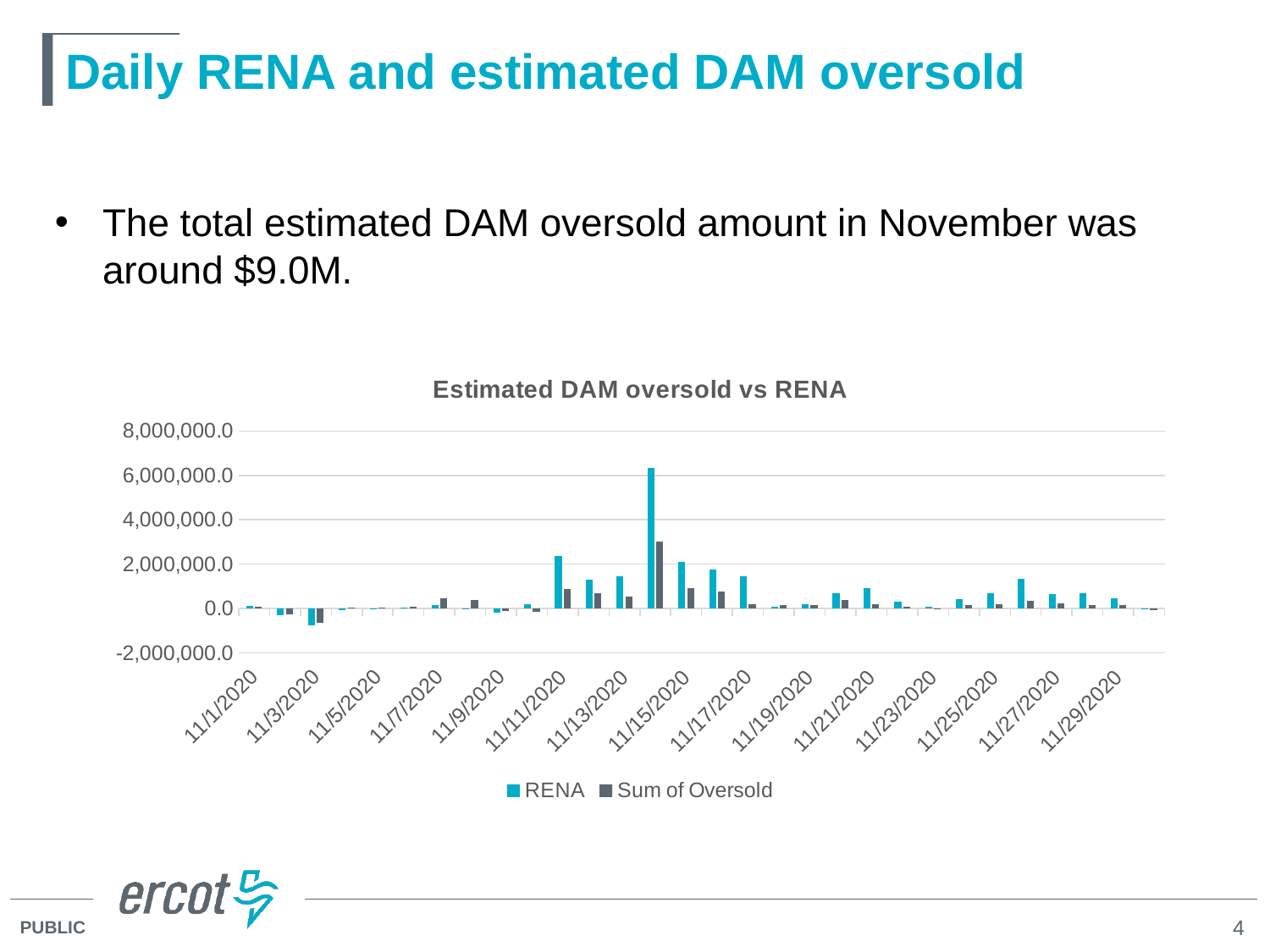
Is the Sum of Oversold value for 11/14/2020 greater or less than 4,000,000.0? less Is the RENA value for 11/10/2020 greater or less than 4,000,000.0? less On 11/14/2020, which series has the larger value, RENA or Sum of Oversold? RENA What is the title of the chart? Estimated DAM oversold vs RENA How many series does the legend of the chart list? 2 Is the RENA value for 11/14/2020 greater or less than 4,000,000.0? greater Which date has the larger RENA value, 11/14/2020 or 11/10/2020? 11/14/2020 What are the two series named in the chart legend? RENA and Sum of Oversold What type of chart is shown on the slide? bar chart On which date is the RENA value highest? 11/14/2020